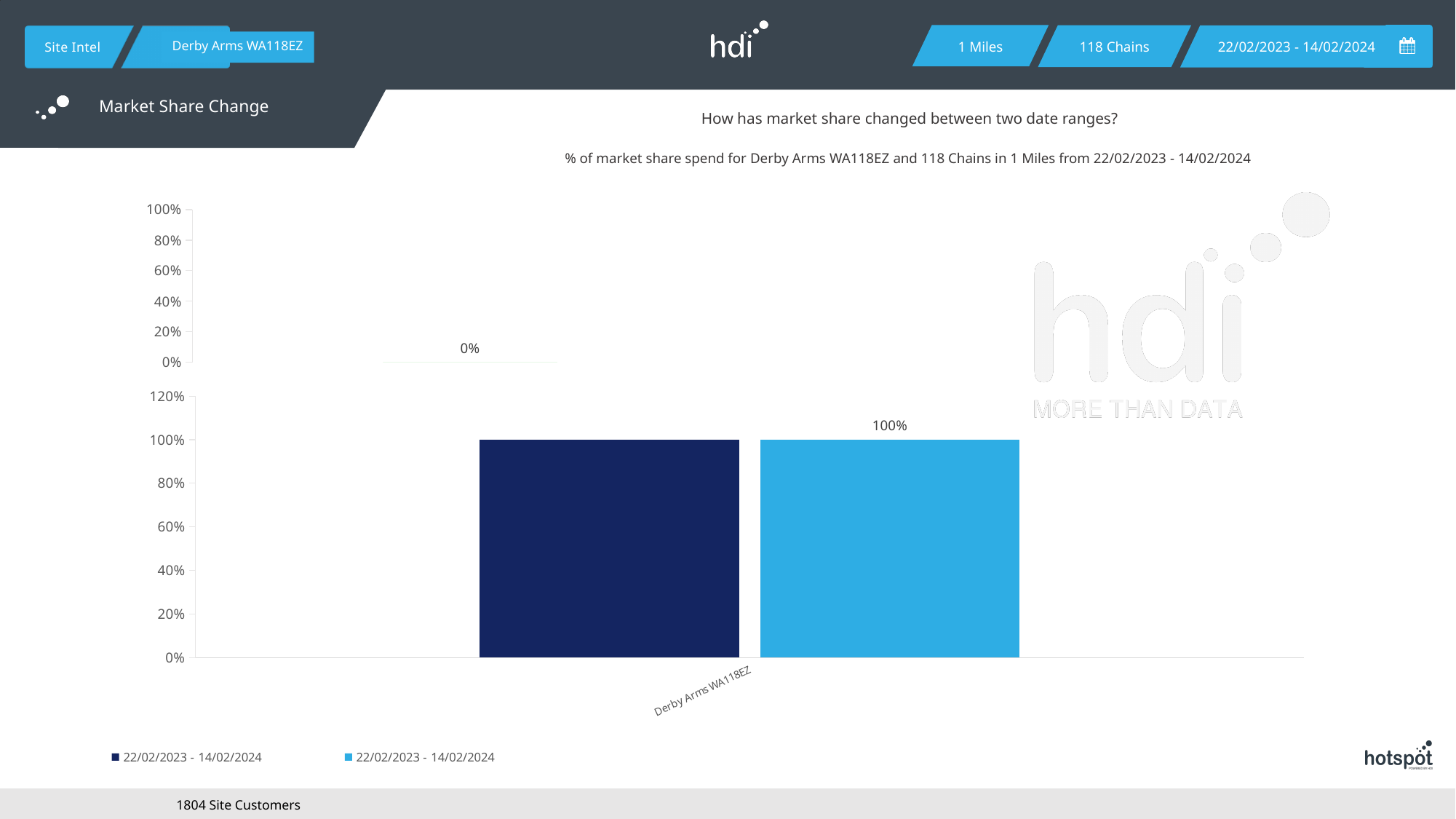
In the lower chart, is the value of the light blue bar greater or less than 80%? greater What kind of chart is the lower chart on the slide? bar chart How many series does the legend at the bottom of the slide list? 2 In the lower chart, is the value of the dark navy bar greater or less than 60%? greater What is the title shown in the header band at the top left of the slide? Market Share Change What is the highest tick value shown on the y axis of the lower chart? 120% In the lower chart, what value does the dark navy bar for Derby Arms WA118EZ reach on the y axis? 100% What is the category label on the x axis of the lower chart? Derby Arms WA118EZ How many categories are shown on the x axis of the lower chart? 1 In the lower chart, what value is printed above the light blue bar for Derby Arms WA118EZ? 100% In the upper chart, what value is printed as the data label? 0%